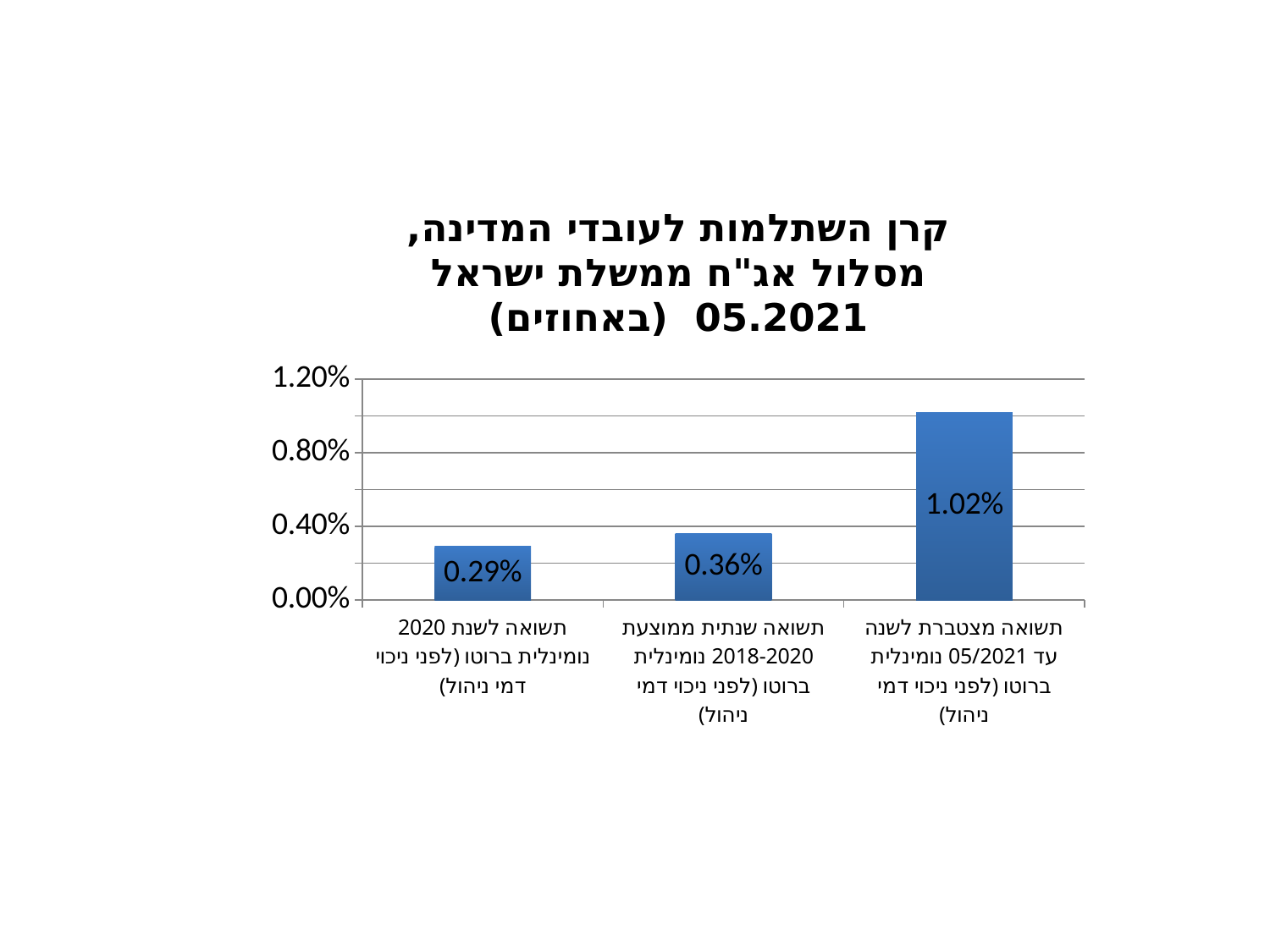
What is the value of the bar for "תשואה שנתית ממוצעת 2018-2020 נומינלית ברוטו" (average annual nominal gross return 2018-2020)? 0.36% Which is larger: the 2020 return or the average annual return 2018-2020? The average annual return 2018-2020 (0.36%) What is the value of the bar for "תשואה לשנת 2020 נומינלית ברוטו (לפני ניכוי דמי ניהול)" (nominal gross return for 2020)? 0.29% How many bars are shown in the chart? 3 Which category has the lowest value? תשואה לשנת 2020 נומינלית ברוטו (לפני ניכוי דמי ניהול) What is the value of the bar for "תשואה מצטברת לשנה עד 05/2021 נומינלית ברוטו" (cumulative nominal gross return for the year to 05/2021)? 1.02% What is the title of the chart? קרן השתלמות לעובדי המדינה, מסלול אג"ח ממשלת ישראל 05.2021 (באחוזים) Is the value for the cumulative return to 05/2021 greater or less than 0.80%? greater Which category has the highest value? תשואה מצטברת לשנה עד 05/2021 נומינלית ברוטו (לפני ניכוי דמי ניהול) What is the difference between the cumulative return to 05/2021 (1.02%) and the 2020 return (0.29%)? 0.73% What is the difference between the average annual return 2018-2020 and the 2020 return? 0.07% What type of chart is shown on the slide? Bar chart